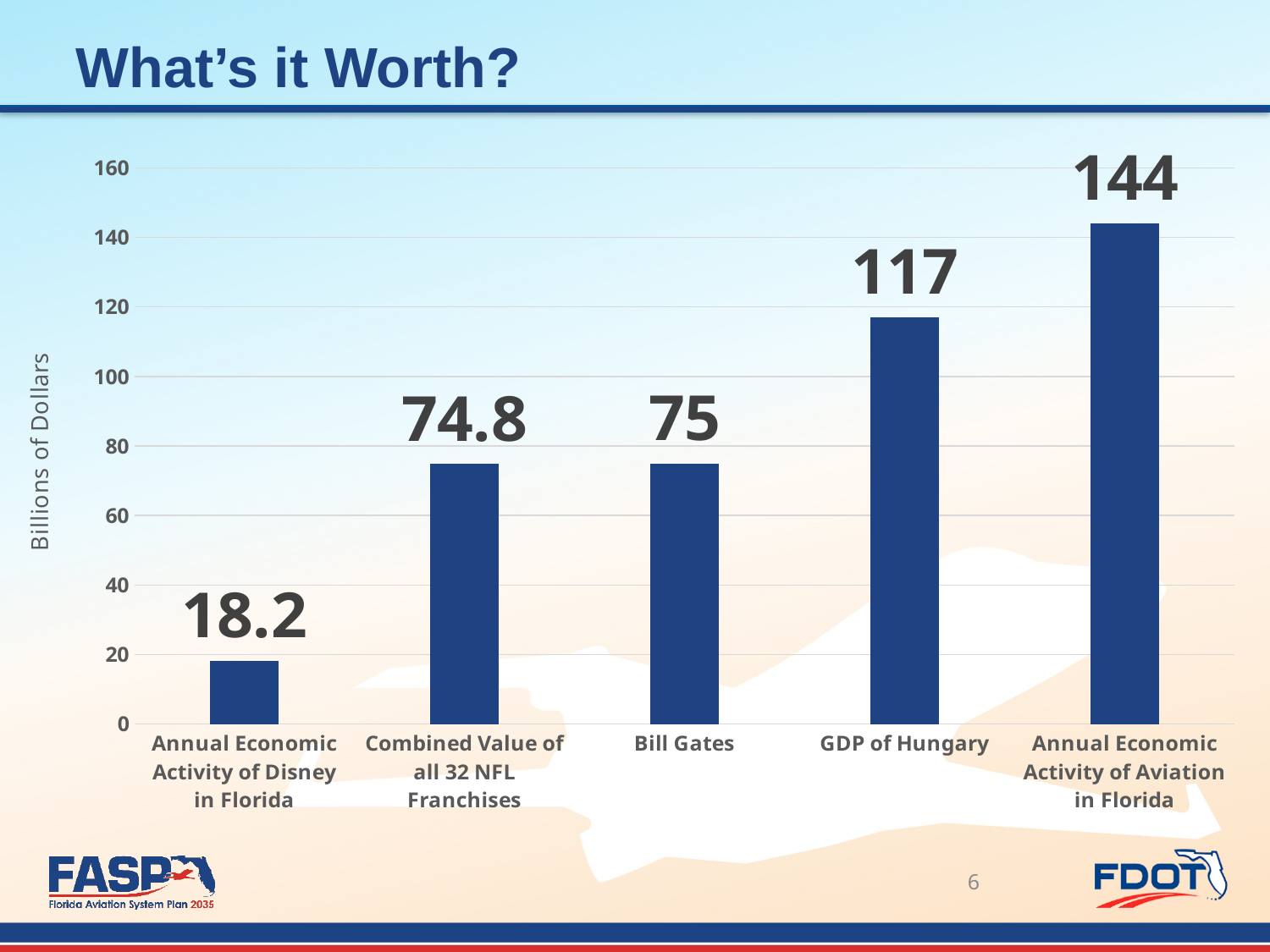
What kind of chart is shown on the slide? Bar chart What is the value for Annual Economic Activity of Disney in Florida? 18.2 What is the value for Combined Value of all 32 NFL Franchises? 74.8 Which is larger, the value for GDP of Hungary or the value for Bill Gates? GDP of Hungary Which category has the lowest value? Annual Economic Activity of Disney in Florida Which category has the highest value? Annual Economic Activity of Aviation in Florida What is the difference between the value for Bill Gates and the value for Annual Economic Activity of Disney in Florida? 56.8 How many categories are shown in the chart? 5 What is the label on the vertical axis of the chart? Billions of Dollars What is the difference between the value for Annual Economic Activity of Aviation in Florida and the value for GDP of Hungary? 27 What is the value for Annual Economic Activity of Aviation in Florida? 144 What is the value for GDP of Hungary? 117